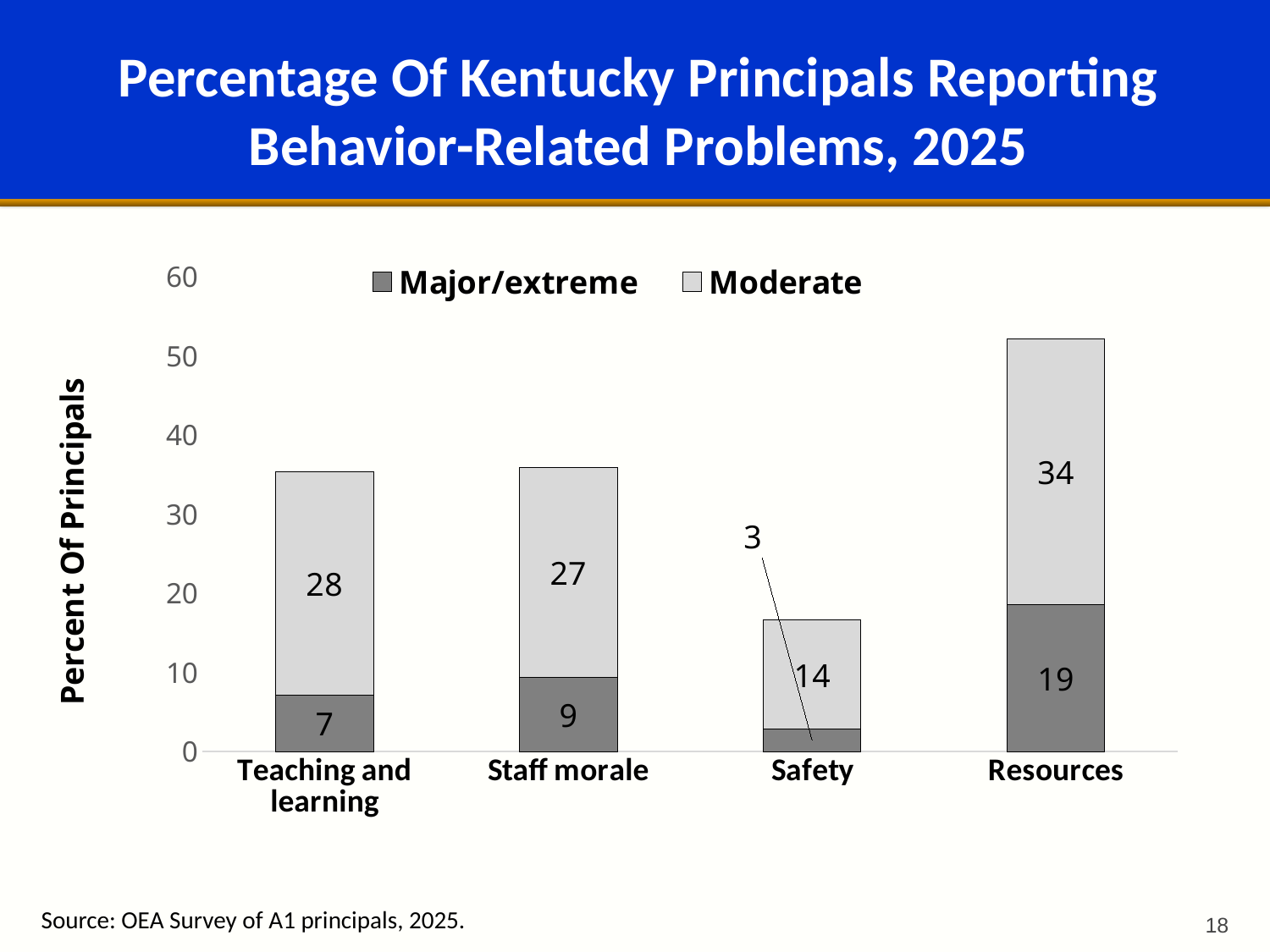
How many categories are shown on the x axis? 4 What is the total of the stacked bar for Safety? 17 How many series does the legend list? 2 What is the Major/extreme value for Safety? 3 What is the Moderate value for Teaching and learning? 28 What is the difference between the Moderate values for Resources and Staff morale? 7 What is the Moderate value for Resources? 34 What is the Major/extreme value for Staff morale? 9 What is the total of the stacked bar for Resources? 53 Which category has the lowest Moderate value? Safety Is the Major/extreme value for Teaching and learning larger or smaller than the Major/extreme value for Resources? smaller Which category has the highest Major/extreme value? Resources